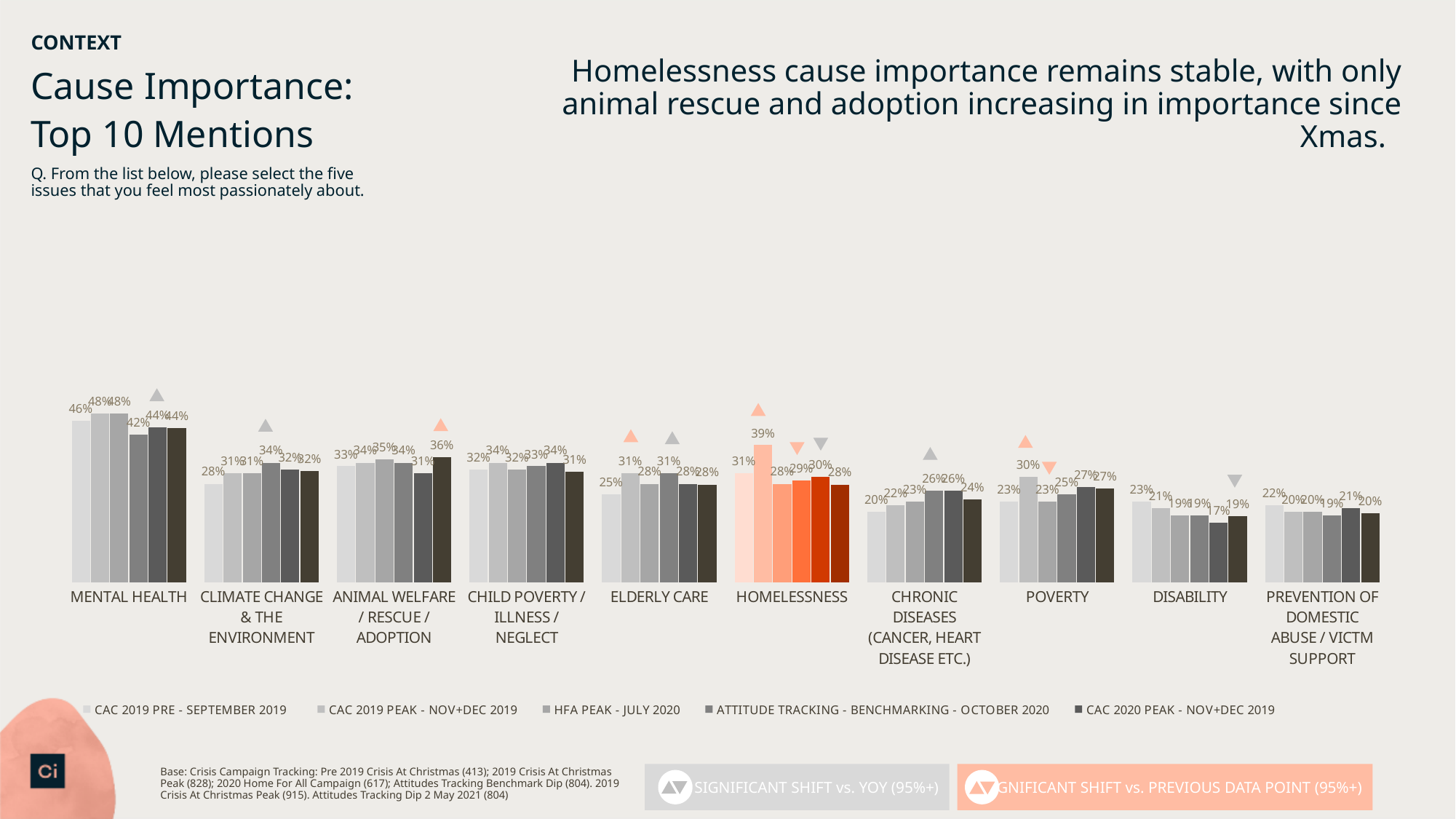
What is the CAC 2019 PEAK - NOV+DEC 2019 value for Homelessness? 39% How many cause categories are shown along the x axis of the chart? 10 Which category's bars are highlighted in orange on the chart? Homelessness For Homelessness, what is the difference between the CAC 2019 PEAK - NOV+DEC 2019 value and the CAC 2019 PRE - SEPTEMBER 2019 value? 8 percentage points How many series does the chart legend list? 5 Which category has the lowest CAC 2019 PRE - SEPTEMBER 2019 value? Chronic Diseases (Cancer, Heart Disease etc.) What is the CAC 2019 PRE - SEPTEMBER 2019 value for Mental Health? 46% For CAC 2019 PRE - SEPTEMBER 2019, which is larger: Mental Health or Climate Change & the Environment? Mental Health What kind of chart is shown on the slide? bar chart What is the CAC 2019 PRE - SEPTEMBER 2019 value for Disability? 23% What is the CAC 2019 PRE - SEPTEMBER 2019 value for Chronic Diseases (Cancer, Heart Disease etc.)? 20% Which category has the highest CAC 2019 PRE - SEPTEMBER 2019 value? Mental Health